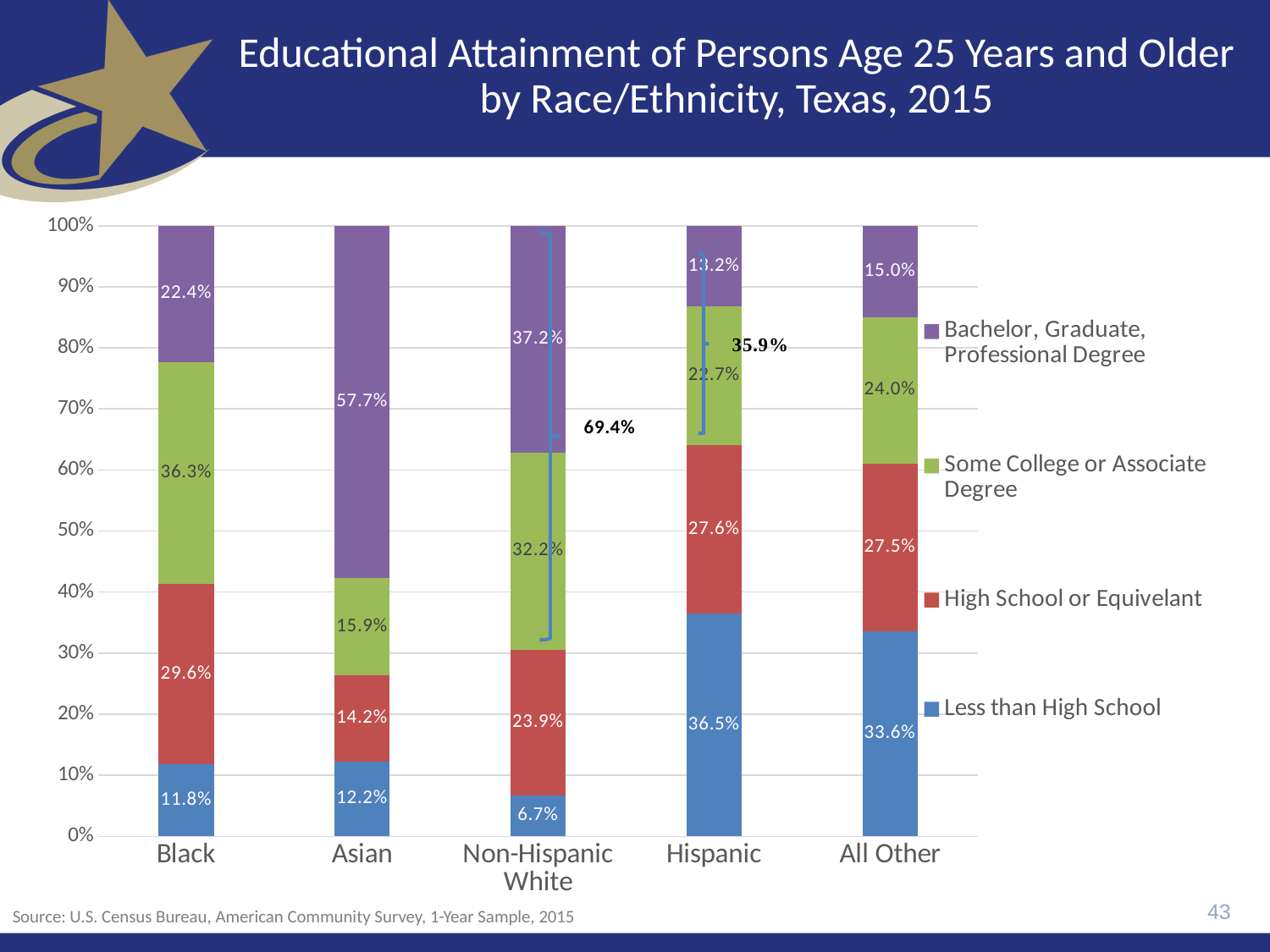
Which is larger, the High School or Equivelant share for Black or for Asian? Black What is the Less than High School share for Hispanic? 36.5% How many race/ethnicity categories are shown on the x axis? 5 What is the High School or Equivelant share for Non-Hispanic White? 23.9% What combined percentage is annotated for Non-Hispanic White's Some College and Bachelor-or-higher segments? 69.4% How many series does the legend list? 4 What is the difference between the Less than High School shares for Hispanic and All Other? 2.9% What is the Bachelor, Graduate, Professional Degree share for Asian? 57.7% Which category has the highest Bachelor, Graduate, Professional Degree share? Asian What is the Some College or Associate Degree share for Black? 36.3% What kind of chart is shown on the slide? Stacked bar chart Which category has the lowest Less than High School share? Non-Hispanic White